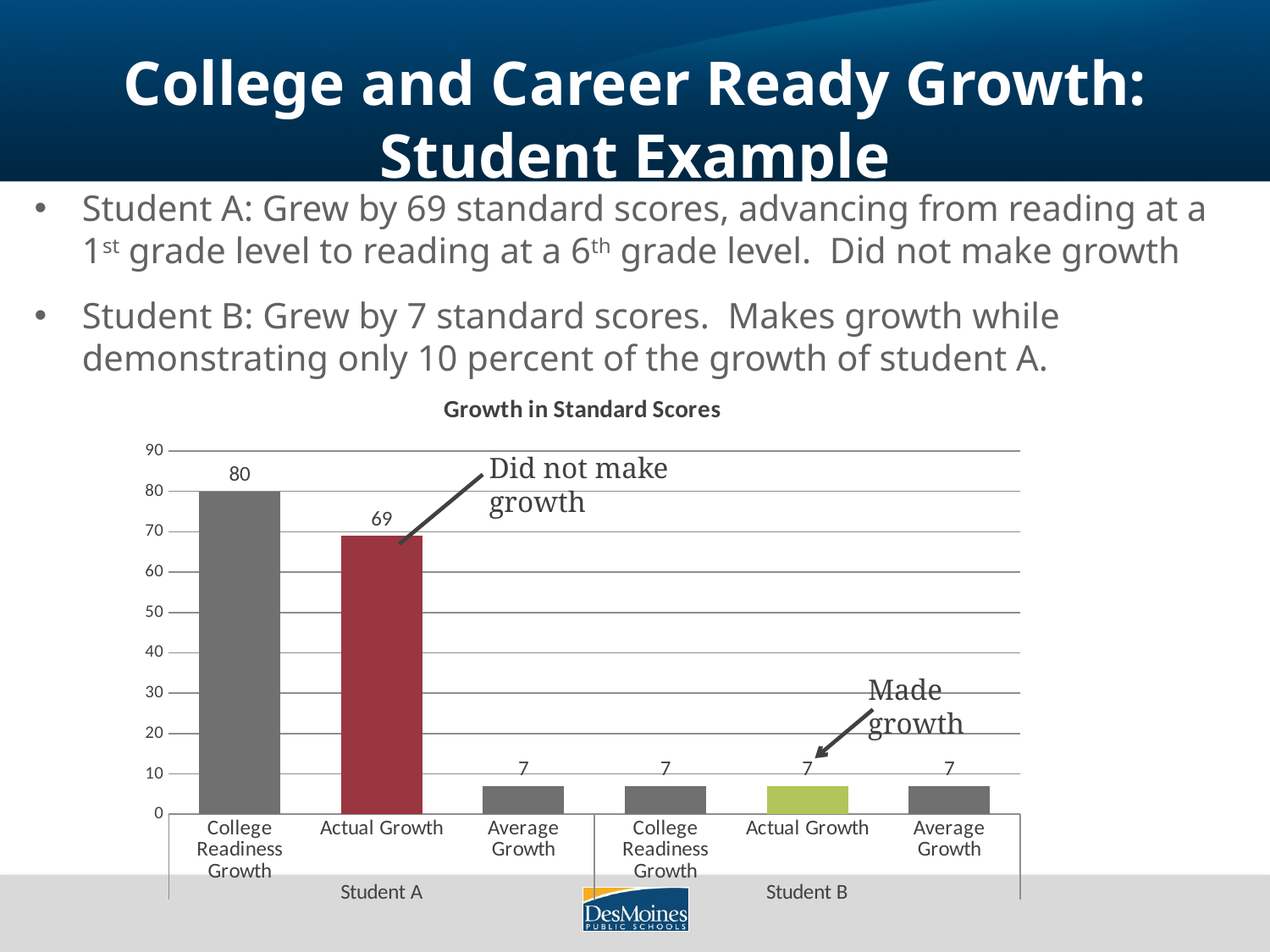
What is the Actual Growth value for Student A? 69 What is the Actual Growth value for Student B? 7 What is the difference between Student A's College Readiness Growth and Actual Growth? 11 What is the College Readiness Growth value for Student A? 80 Which bar has the highest value in the chart? College Readiness Growth (Student A) Is the Actual Growth value for Student A greater or less than 60? greater How many bars are plotted in the chart? 6 What is the difference between Student A's Actual Growth and Student B's Actual Growth? 62 What is the title of the chart? Growth in Standard Scores What kind of chart is shown on the slide? Bar chart Which is larger: Student A's Actual Growth or Student A's Average Growth? Student A's Actual Growth What is the College Readiness Growth value for Student B? 7